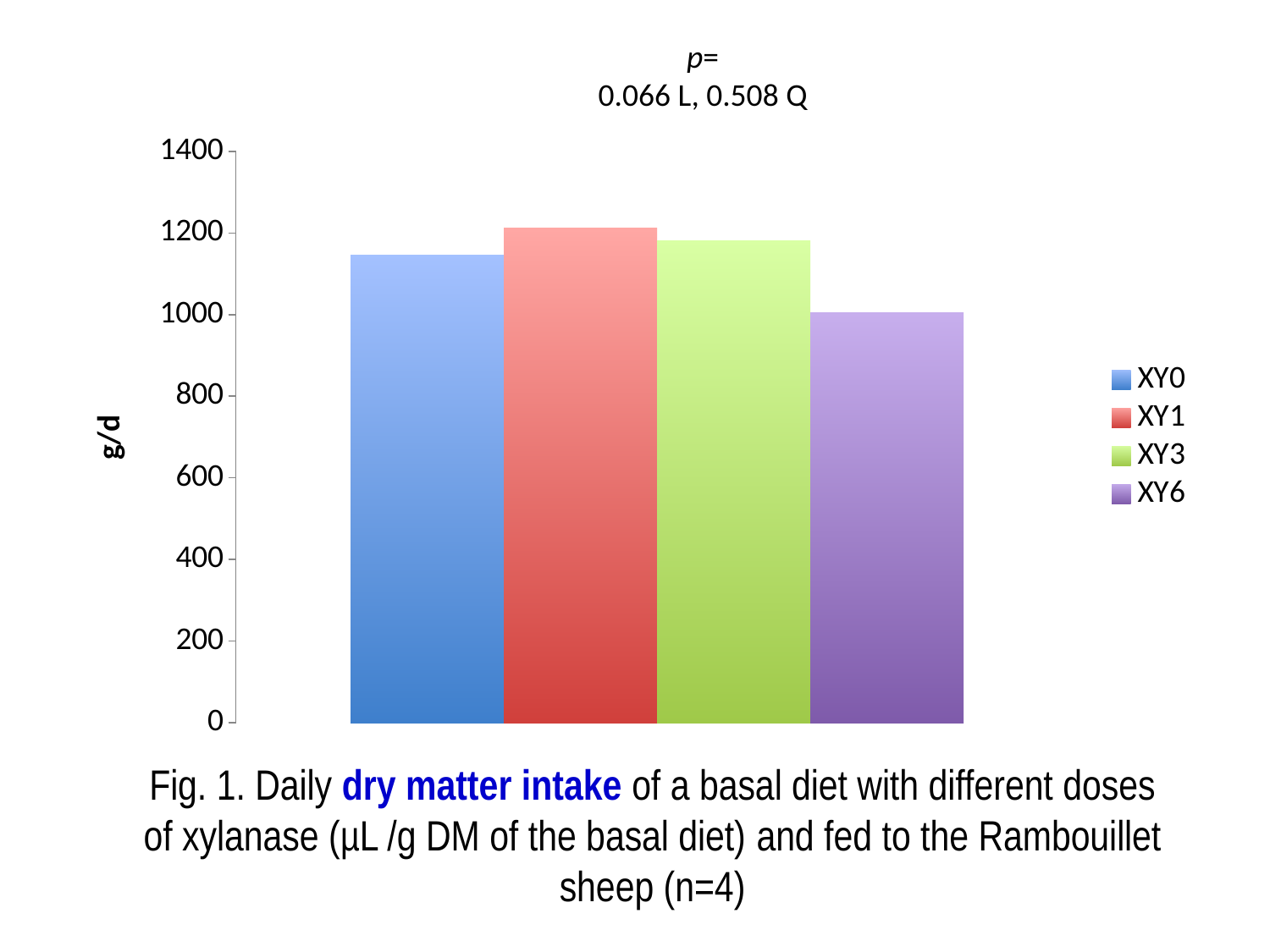
Which is larger, the value for XY1 or the value for XY6? XY1 Is the value for XY3 greater or less than 1000? greater Which treatment has the highest daily dry matter intake? XY1 Is the value for XY6 greater or less than 1200? less What is the label on the vertical axis of the chart? g/d How many bars are plotted in the chart? 4 What p-values are printed above the chart? 0.066 L, 0.508 Q Is the value for XY0 greater or less than 1000? greater What kind of chart is shown on the slide? bar chart Which treatment has the lowest daily dry matter intake? XY6 Which is larger, the value for XY0 or the value for XY6? XY0 How many entries does the legend list? 4